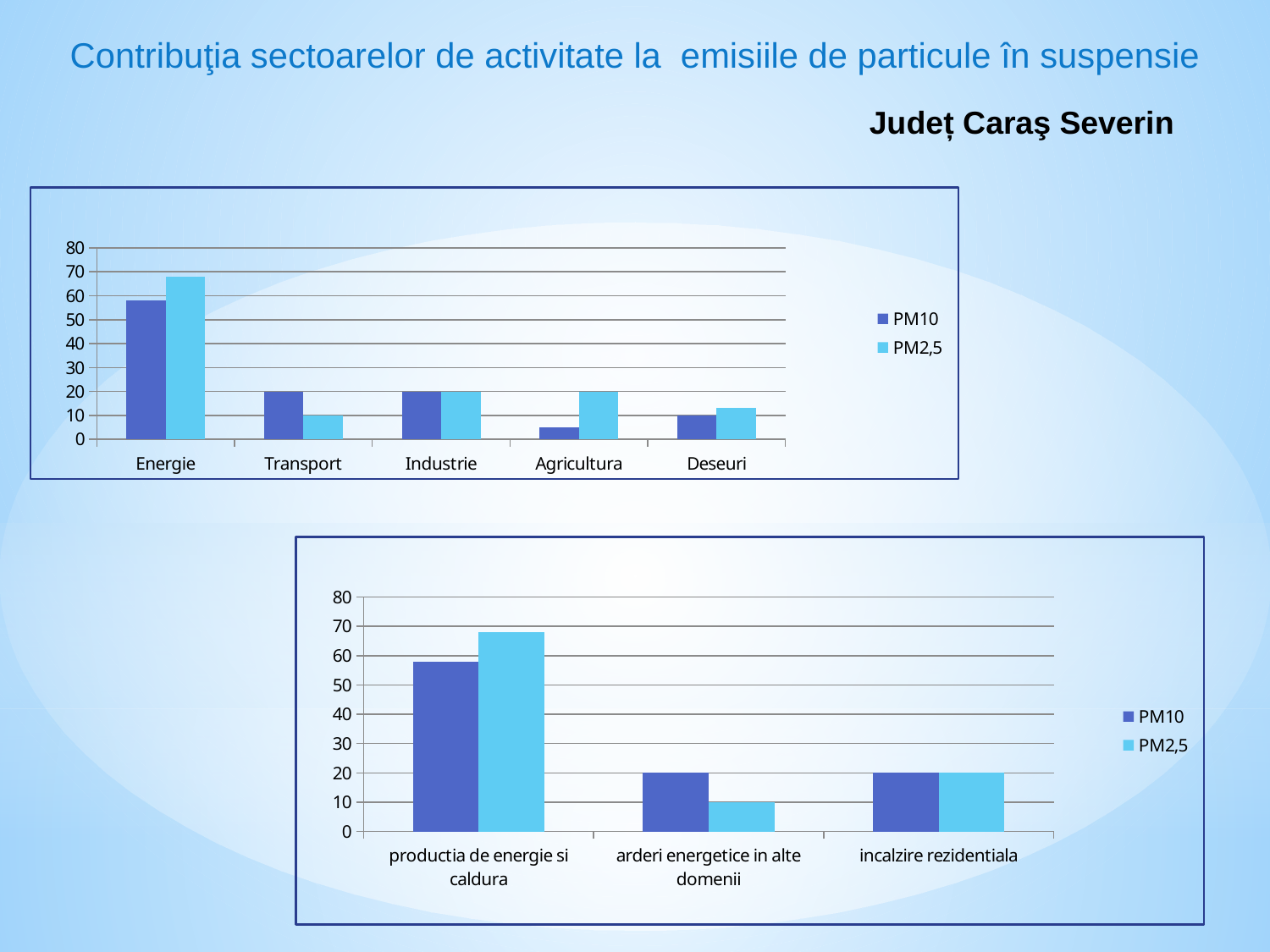
In the top chart, is the PM2,5 value for Energie greater or less than 60? greater In the bottom chart, is the PM10 value for arderi energetice in alte domenii greater or less than 30? less In the top chart, which is larger for Transport: PM10 or PM2,5? PM10 What are the two legend entries in the bottom chart? PM10 and PM2,5 How many categories are shown on the x axis of the bottom chart? 3 In the top chart, which category has the lowest PM10 value? Agricultura How many categories are shown on the x axis of the top chart? 5 In the bottom chart, which category has the highest PM2,5 value? productia de energie si caldura In the top chart, which category has the highest PM10 value? Energie What kind of chart is the top chart on the slide? bar chart How many series does the legend of the top chart list? 2 In the top chart, is the PM10 value for Agricultura greater or less than 10? less